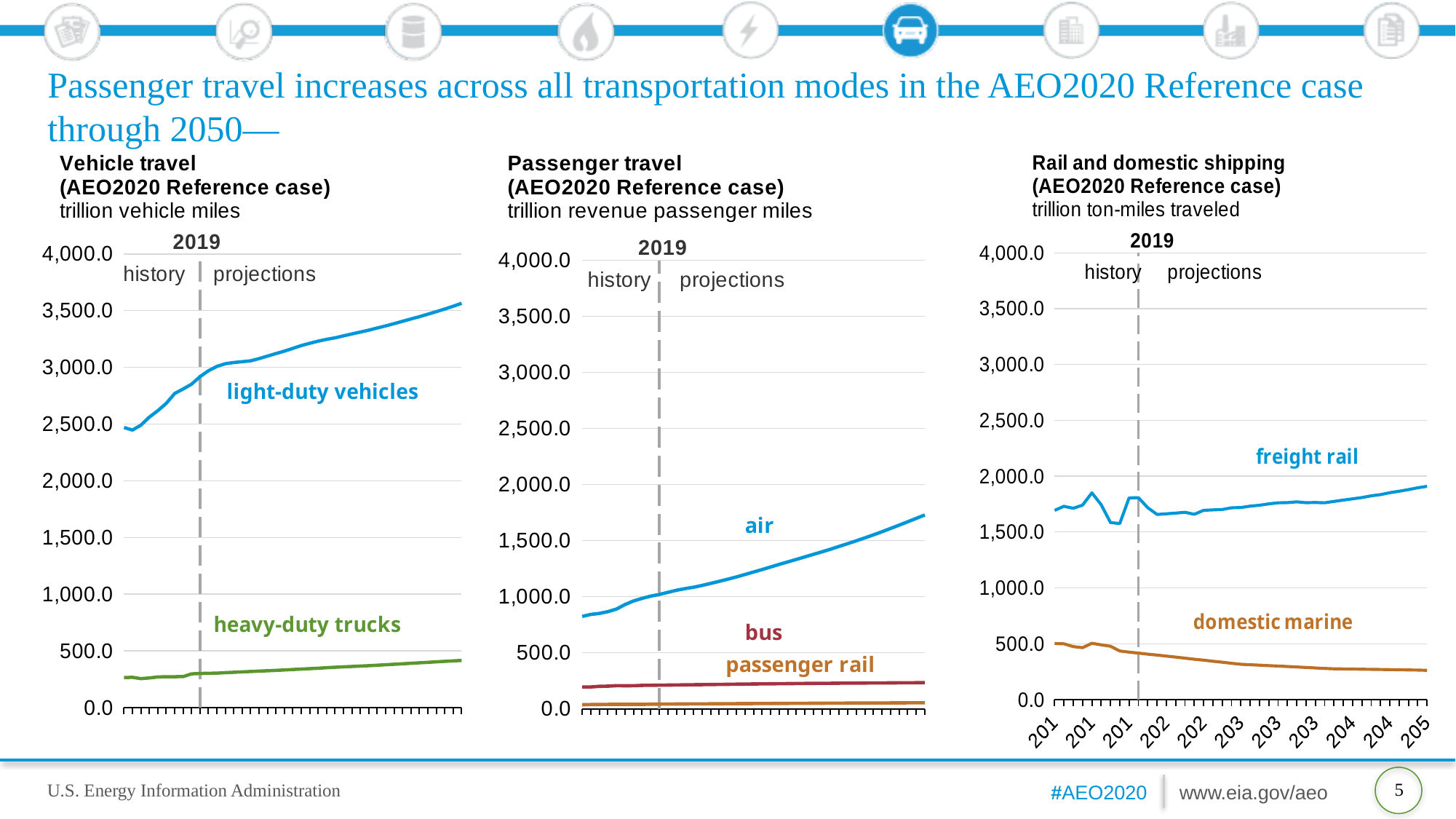
On the Rail and domestic shipping chart, does the domestic marine series rise or fall over the projection period? fall On the Passenger travel chart, which series has the lowest values? passenger rail What kind of chart is the Vehicle travel (AEO2020 Reference case) chart? line chart How many series are plotted on the Passenger travel (AEO2020 Reference case) chart? 3 What year does the dashed vertical line separating history from projections mark on the three charts? 2019 On the Vehicle travel chart, is the value for light-duty vehicles at the end of the projection period greater or less than 3,000.0? greater On the Rail and domestic shipping chart, which series has the highest values? freight rail On the Passenger travel chart, is the value for air at the start of the history period greater or less than 1,000.0? less On the Passenger travel chart, which series has higher values, bus or passenger rail? bus On the Vehicle travel chart, is the value for heavy-duty trucks at the end of the projection period greater or less than 500.0? less On the Passenger travel chart, does the air series rise or fall over the projection period? rise